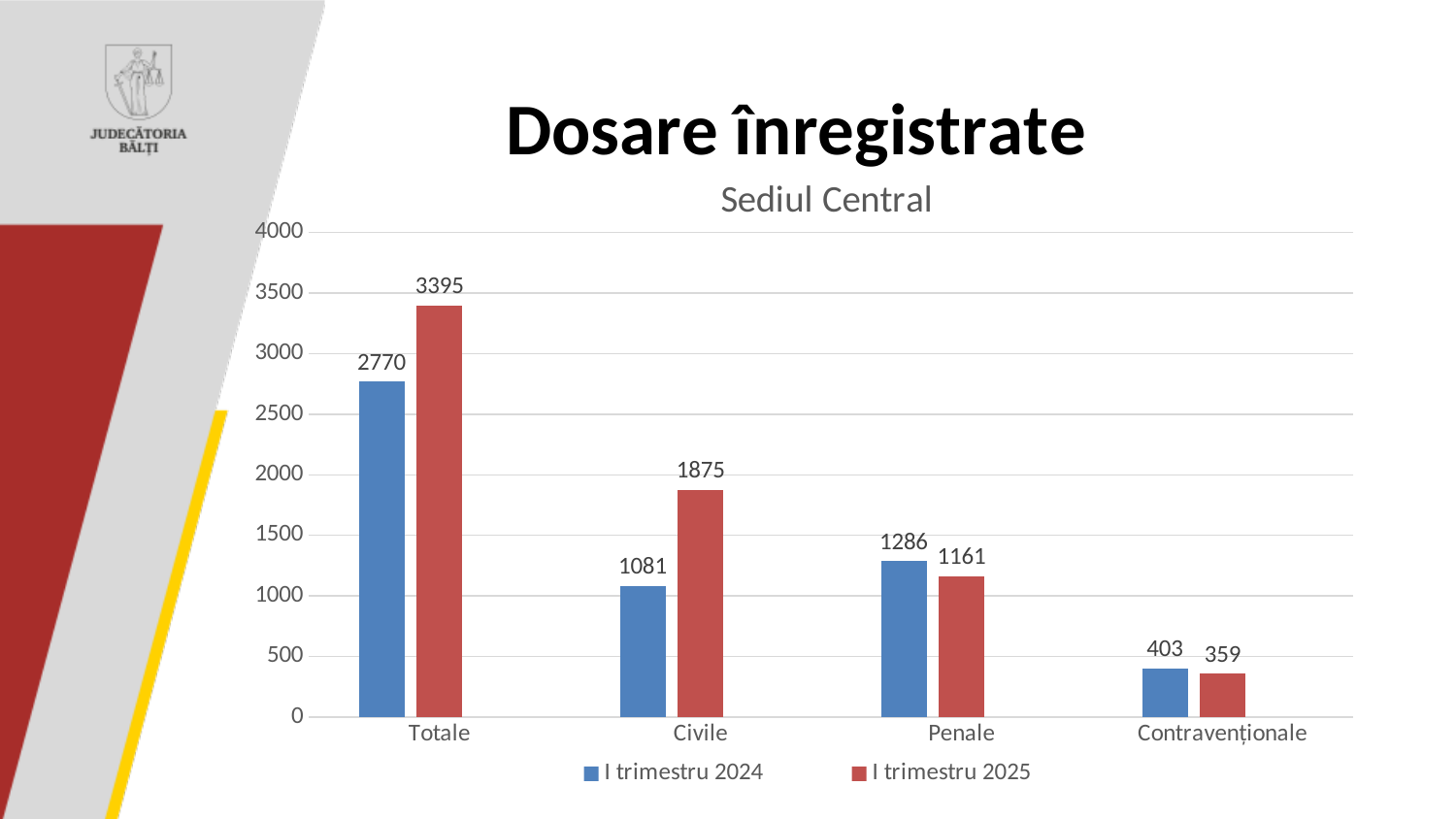
What is the value for Totale in the I trimestru 2025 series? 3395 For Penale, which series has the larger value, I trimestru 2024 or I trimestru 2025? I trimestru 2024 What is the difference between the I trimestru 2025 and I trimestru 2024 values for Civile? 794 What is the value for Civile in the I trimestru 2024 series? 1081 What is the subtitle shown above the chart? Sediul Central Which category has the highest value in the I trimestru 2025 series? Totale What is the value for Contravenționale in the I trimestru 2025 series? 359 How many series does the legend list? 2 What is the difference between the I trimestru 2024 and I trimestru 2025 values for Penale? 125 Which category has the lowest value in the I trimestru 2024 series? Contravenționale What kind of chart is shown on the slide? Bar chart How many categories are shown on the x axis? 4